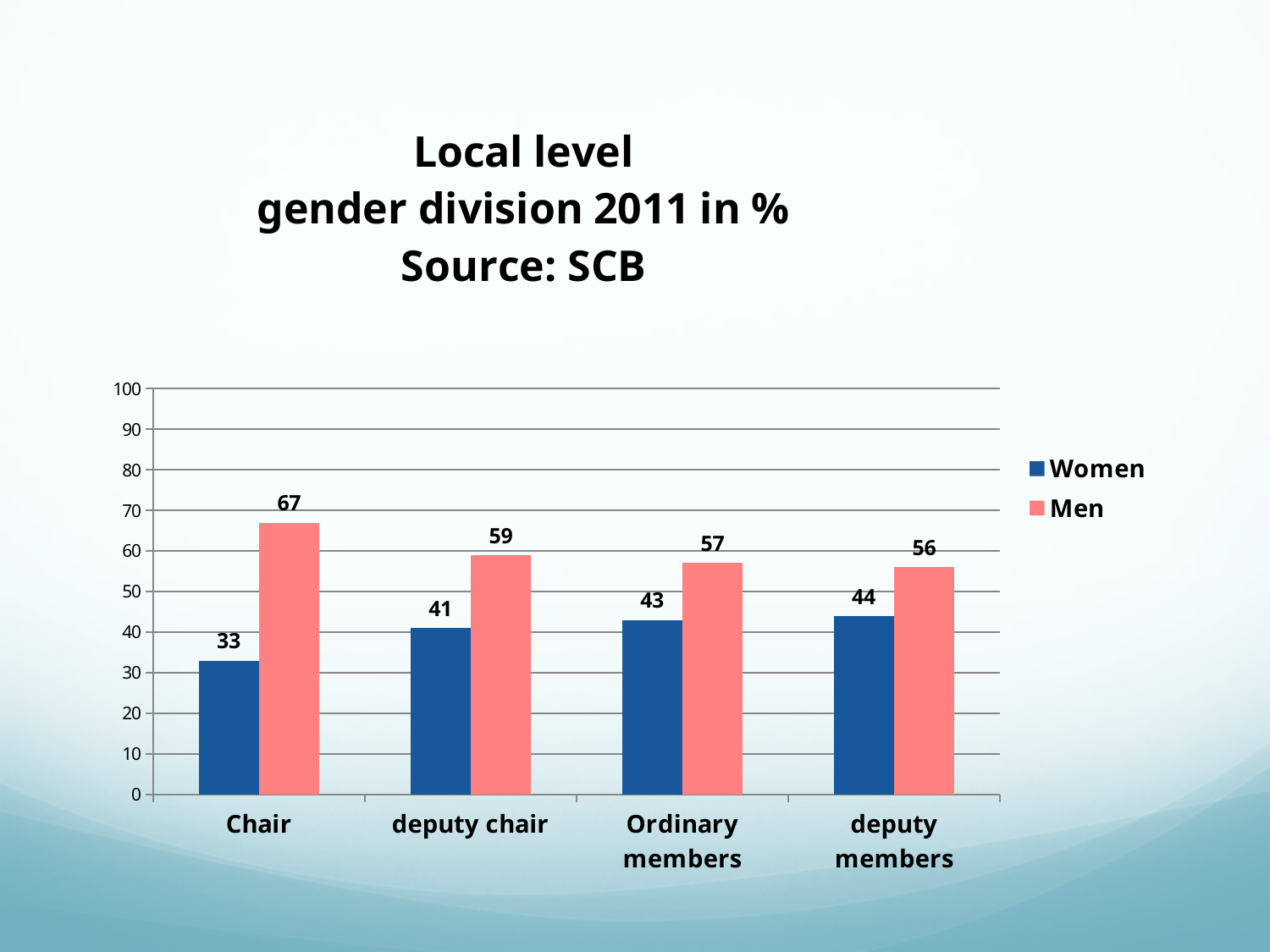
What kind of chart is shown on the slide? Bar chart Which is larger in the deputy members category, Women or Men? Men What is the value for Women in the Chair category? 33 How many categories are shown on the x axis? 4 Which category has the lowest value for Women? Chair Which category has the highest value for Men? Chair How many series does the legend list? 2 Do the Women values rise or fall from Chair to deputy members along the x axis? Rise What is the difference between the Men and Women values in the Chair category? 34 What is the value for Women in the Ordinary members category? 43 What is the source given in the chart title? SCB What is the value for Men in the deputy chair category? 59